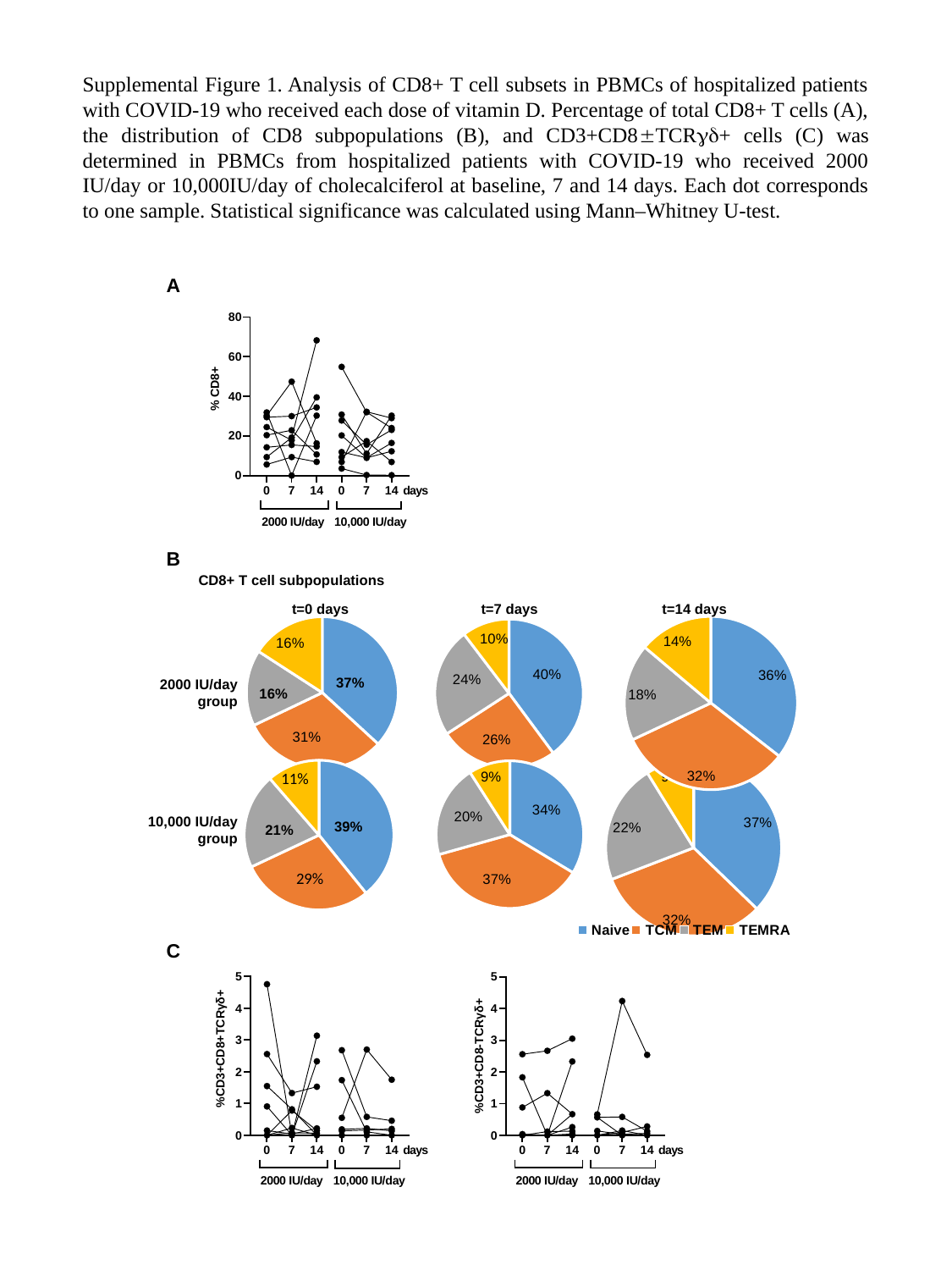
In panel B, which subpopulation has the largest share in the 2000 IU/day group pie at t=7 days? Naive What kind of chart is used in panel B? Pie chart How many pie charts are shown in panel B? 6 In panel B, in the 2000 IU/day group at t=14 days, what is the difference between the Naive share and the TEM share? 18% In panel B, in the 10,000 IU/day group at t=7 days, which is larger, the Naive share or the TCM share? TCM What is the title of panel B? CD8+ T cell subpopulations How many entries does the legend of panel B list? 4 In panel B, which subpopulation has the smallest share in the 10,000 IU/day group pie at t=7 days? TEMRA In panel B, what is the TEM share in the 10,000 IU/day group pie at t=0 days? 21% In panel B, what percentage of CD8+ T cells are Naive in the 2000 IU/day group at t=0 days? 37% In panel B, what is the TEMRA share in the 2000 IU/day group pie at t=7 days? 10% In panel B, what is the TCM share in the 10,000 IU/day group pie at t=7 days? 37%